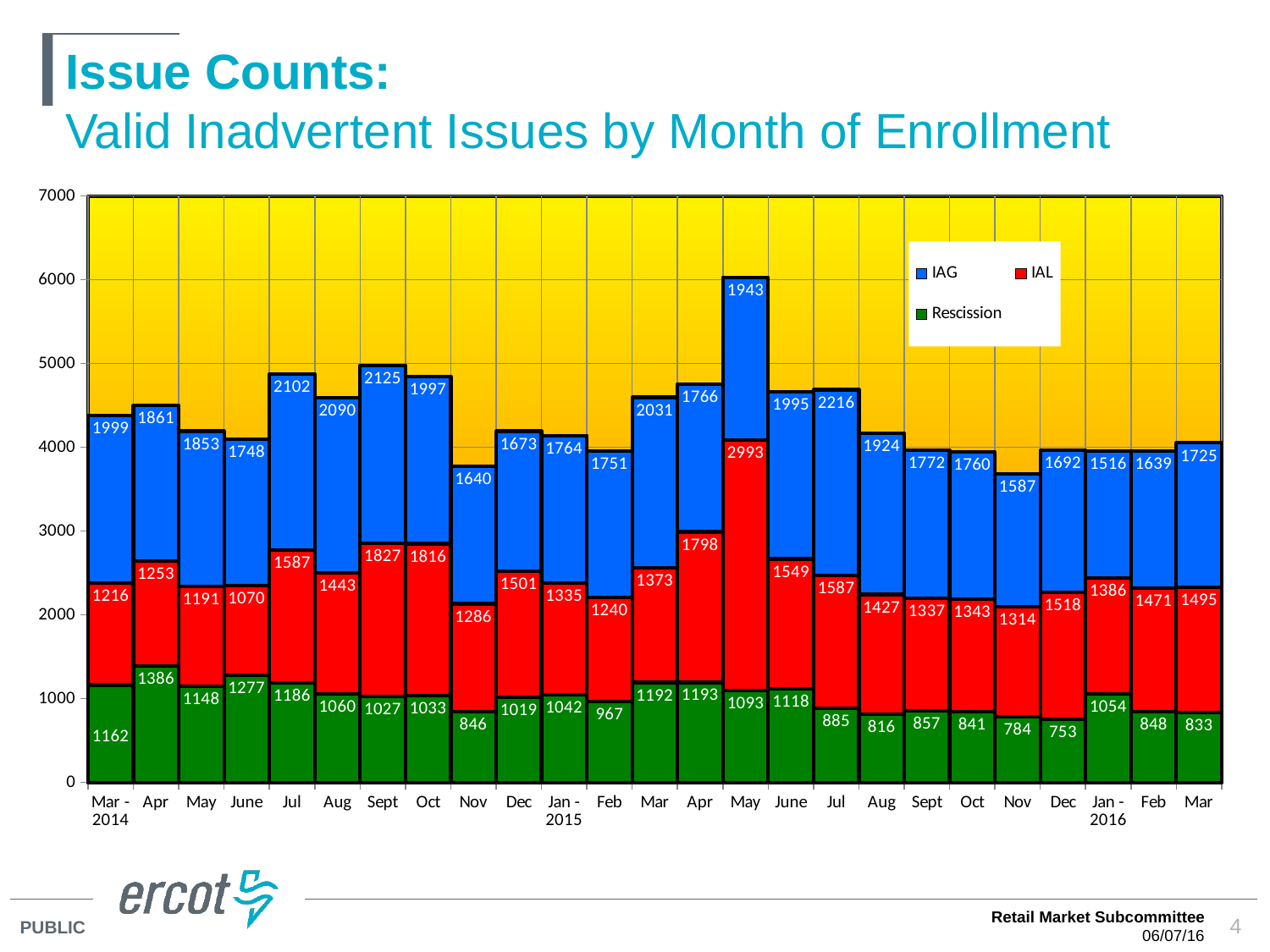
Which month has the highest IAG value? Jul 2015 How many months are shown on the x axis? 25 How many series does the legend list? 3 What is the IAL value for May 2015? 2993 Which is larger, the Rescission value for Apr 2014 or for Apr 2015? Apr 2014 What is the Rescission value for Mar 2014? 1162 What is the IAG value for Sept 2014? 2125 Which month has the highest IAL value? May 2015 Which month has the lowest Rescission value? Dec 2015 What kind of chart is shown on the slide? Stacked bar chart What is the difference between the IAG values for Jul 2015 and Jan 2016? 700 What is the total of the stacked bar for May 2015? 6029